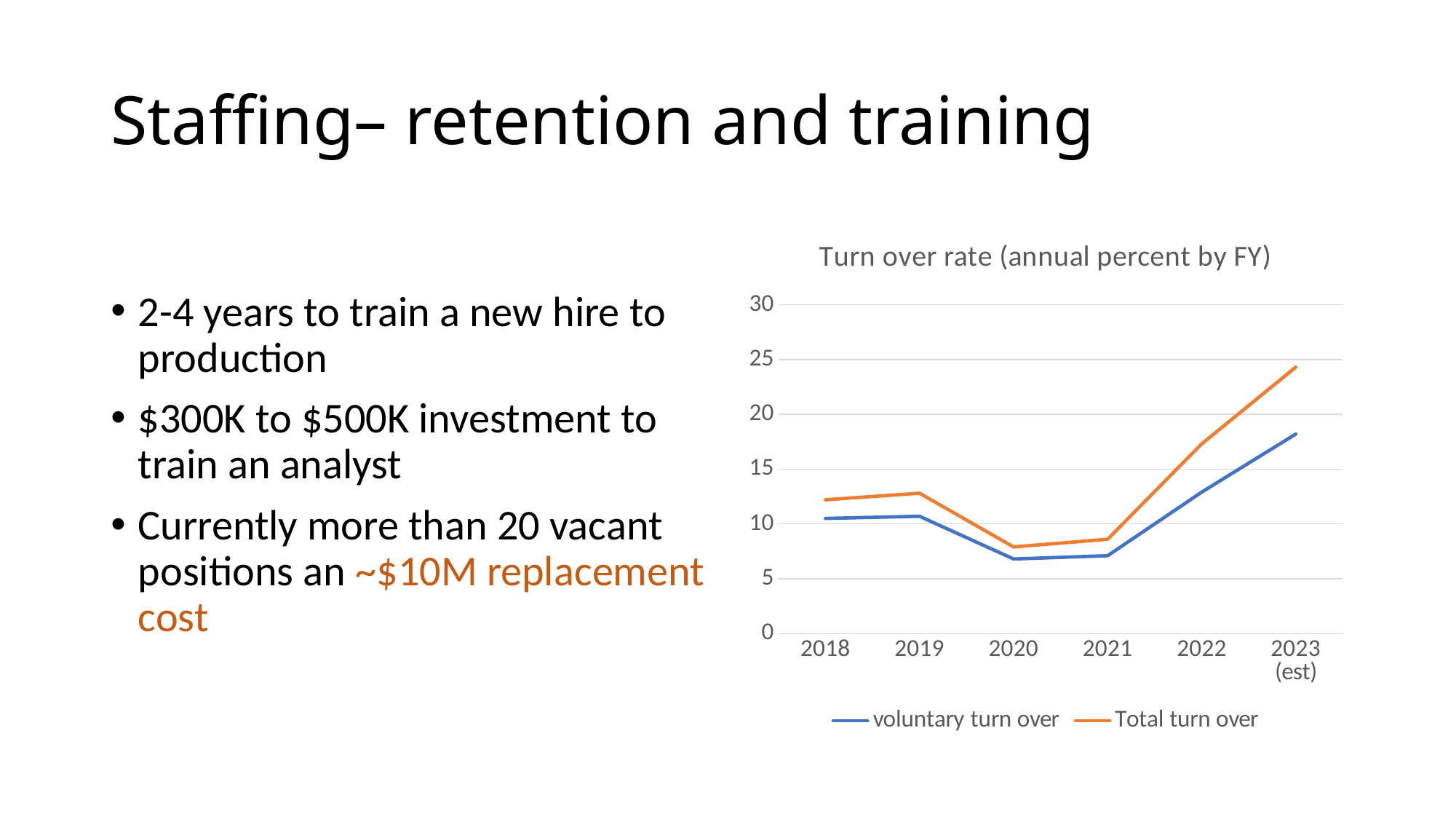
Which year has the lowest voluntary turn over? 2020 How many series does the chart legend list? 2 Is the Total turn over for 2023 (est) greater or less than 20? greater How many years are shown on the x axis of the chart? 6 Does the voluntary turn over rise or fall from 2021 to 2023 (est)? rise Which series is drawn in orange in the chart? Total turn over What is the title of the chart? Turn over rate (annual percent by FY) Is the voluntary turn over for 2020 greater or less than 10? less Which year has the highest Total turn over? 2023 (est) Is the Total turn over for 2022 greater or less than 15? greater Which is larger in 2021, voluntary turn over or Total turn over? Total turn over What kind of chart is shown on the slide? line chart